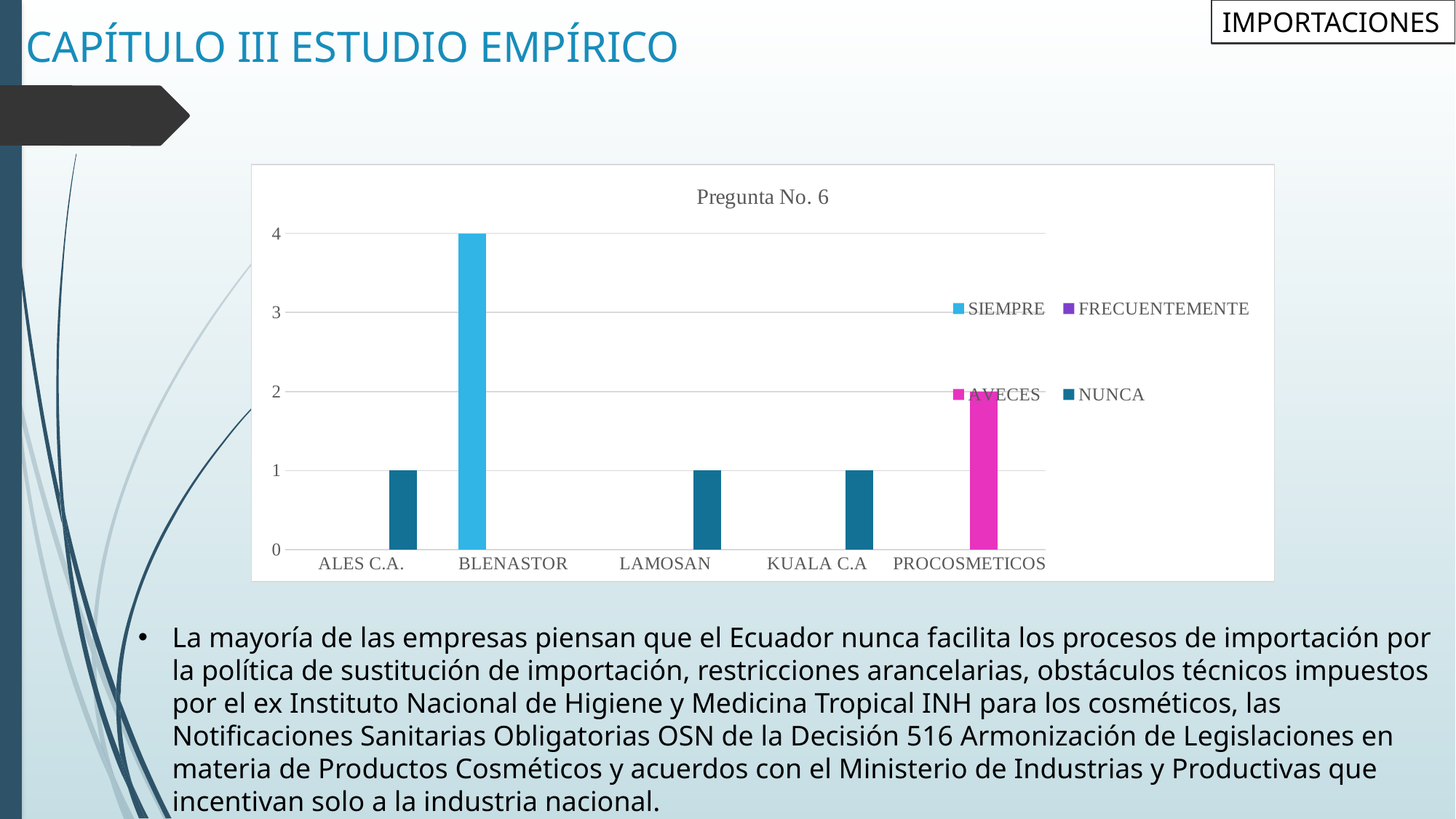
Which series does the bar for ALES C.A. belong to? NUNCA What is the value of the NUNCA bar for LAMOSAN? 1 What is the value of the SIEMPRE bar for BLENASTOR? 4 Is the value for BLENASTOR greater or less than 3? greater How many categories are shown on the x axis of the chart? 5 How many series does the chart legend list? 4 What is the value of the AVECES bar for PROCOSMETICOS? 2 What kind of chart is shown on the slide? bar chart What is the difference between the BLENASTOR bar and the PROCOSMETICOS bar? 2 Which category has the tallest bar in the chart? BLENASTOR Which is larger, the bar for PROCOSMETICOS or the bar for KUALA C.A? PROCOSMETICOS What is the title of the chart? Pregunta No. 6